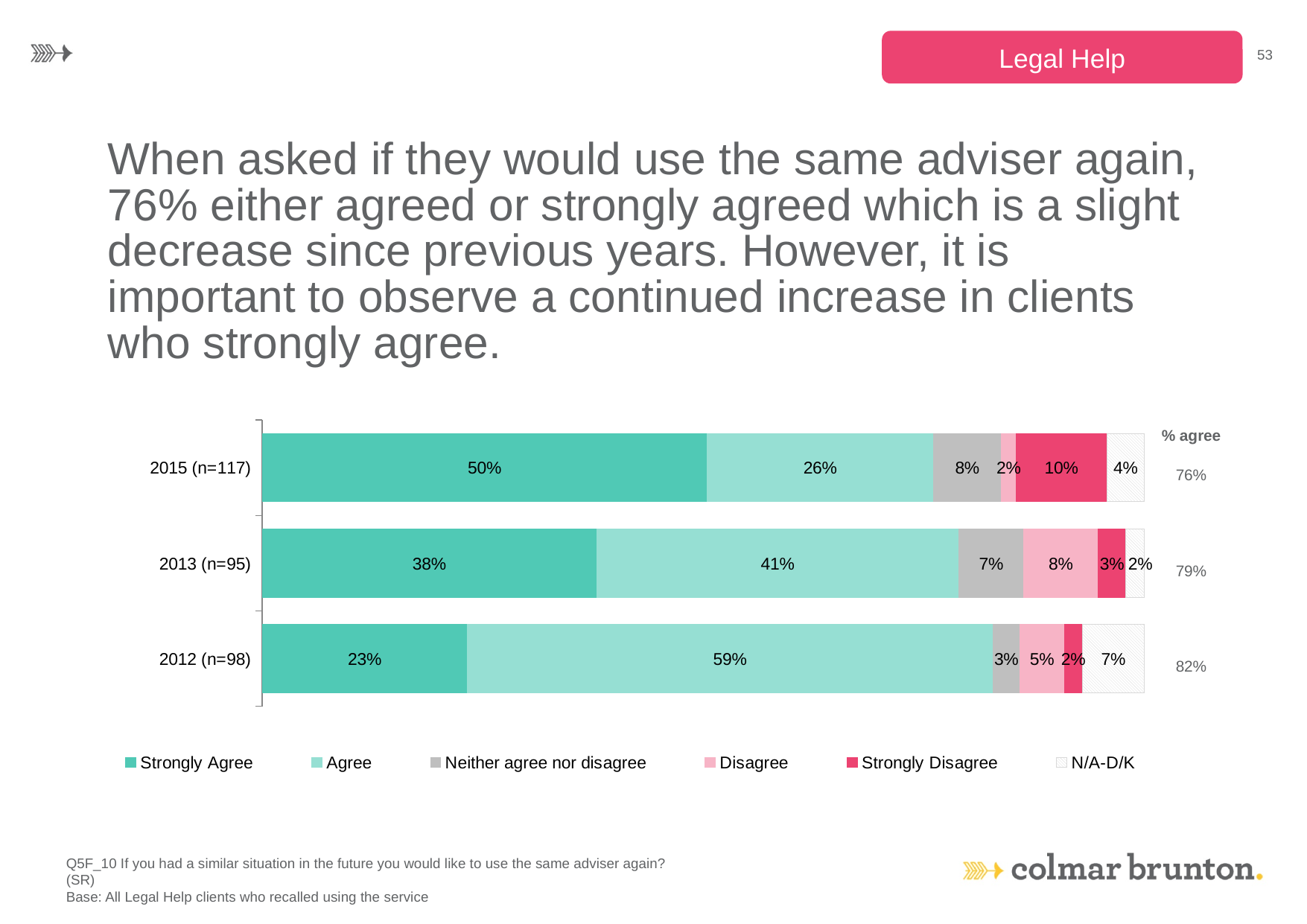
How many years (bars) are shown in the chart? 3 What is the Agree value for 2012 (n=98)? 59% What kind of chart is shown on the slide? Stacked bar chart What percentage of 2015 (n=117) respondents strongly agreed? 50% Which year has the larger Disagree value, 2013 (n=95) or 2012 (n=98)? 2013 (n=95) What is the Strongly Disagree value for 2015 (n=117)? 10% How many percentage points higher is Strongly Agree in 2015 (n=117) than in 2013 (n=95)? 12 What is the % agree figure shown for 2012 (n=98)? 82% Does the Strongly Agree share rise or fall from 2012 to 2015? Rise How many series does the legend list? 6 Which year has the lowest Agree percentage? 2015 (n=117) Which year has the highest Strongly Agree percentage? 2015 (n=117)